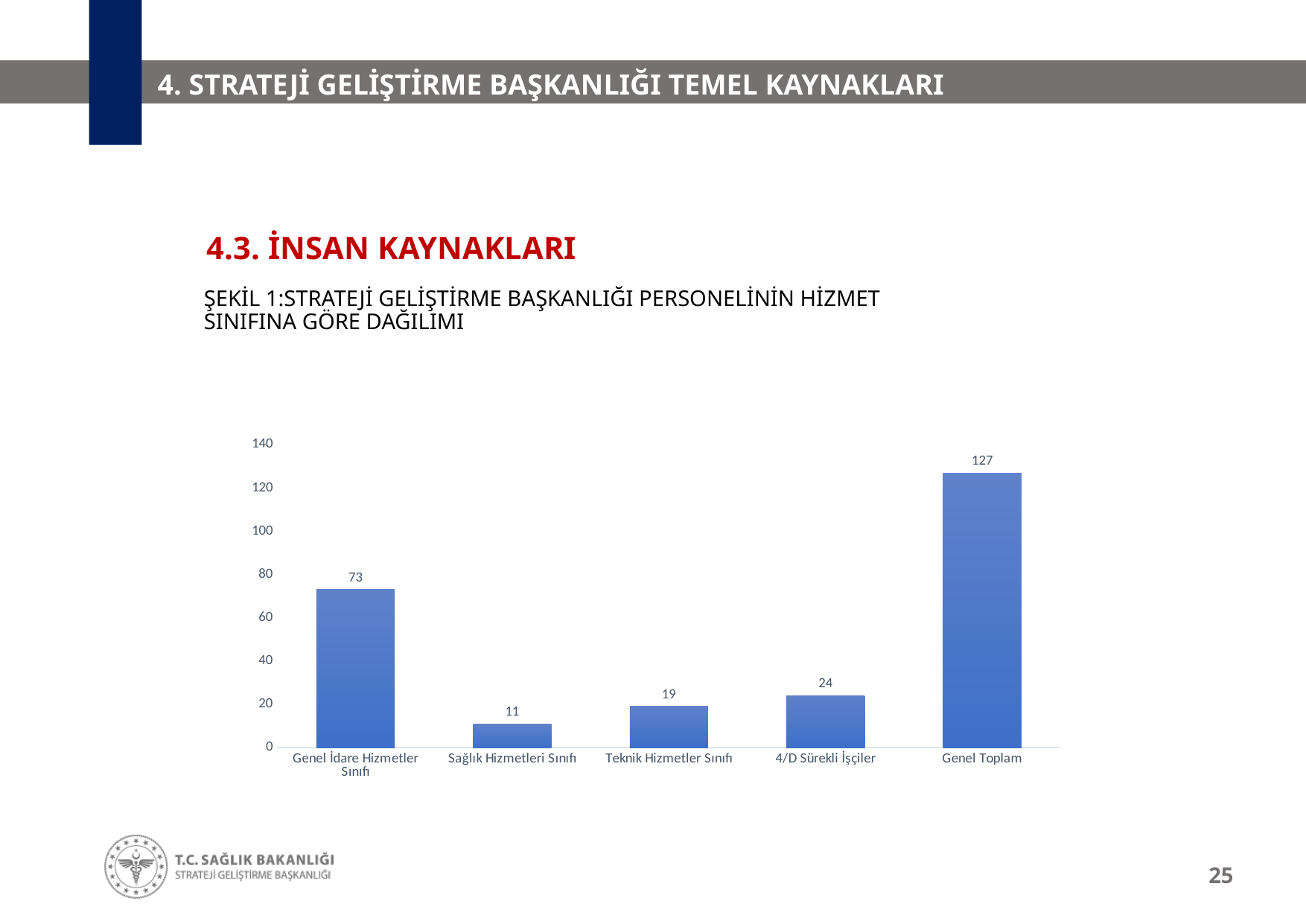
Which is larger, the value for Teknik Hizmetler Sınıfı or the value for 4/D Sürekli İşçiler? 4/D Sürekli İşçiler What is the value for Teknik Hizmetler Sınıfı? 19 What is the value for Genel Toplam? 127 What is the value for Genel İdare Hizmetler Sınıfı? 73 Which category has the lowest value? Sağlık Hizmetleri Sınıfı What kind of chart is shown on the slide? bar chart What is the value for 4/D Sürekli İşçiler? 24 What is the value for Sağlık Hizmetleri Sınıfı? 11 How many categories are shown on the x axis? 5 What is the difference between the values for Genel İdare Hizmetler Sınıfı and 4/D Sürekli İşçiler? 49 Is the value for Genel Toplam greater or less than 120? greater Which category has the highest value? Genel Toplam